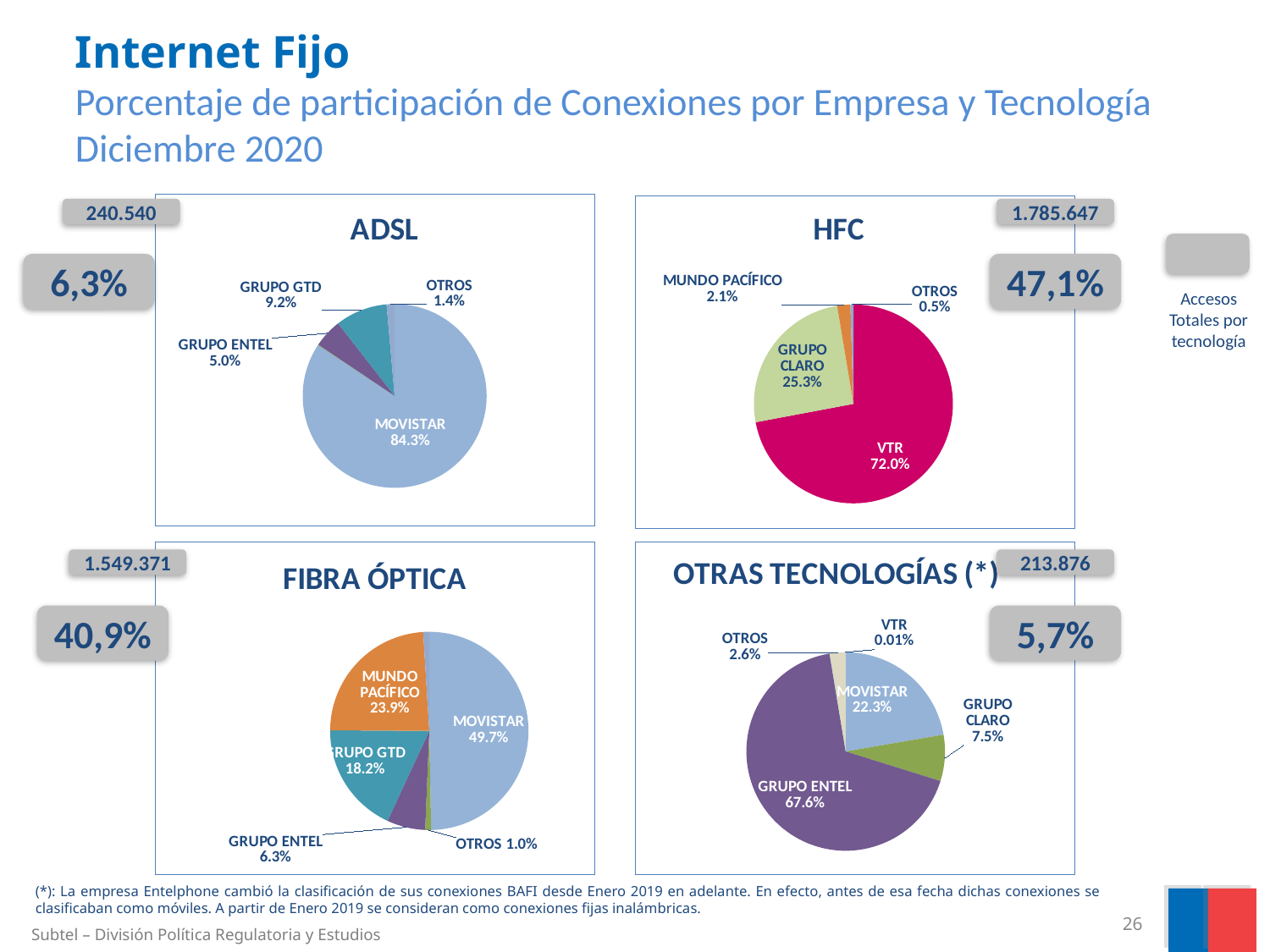
In the HFC chart, what is the value for GRUPO CLARO? 25.3% In the OTRAS TECNOLOGÍAS (*) chart, what is the difference between GRUPO ENTEL and MOVISTAR? 45.3% How many slices does the FIBRA ÓPTICA chart have? 6 How many pie charts are shown on the slide? 4 In the ADSL chart, what share does MOVISTAR hold? 84.3% What type of chart is the HFC chart? Pie chart In the HFC chart, which company has the largest share? VTR In the ADSL chart, which is larger, GRUPO GTD or GRUPO ENTEL? GRUPO GTD In the HFC chart, what is the combined share of MUNDO PACÍFICO and OTROS? 2.6% In the FIBRA ÓPTICA chart, what is the value for MUNDO PACÍFICO? 23.9% In the OTRAS TECNOLOGÍAS (*) chart, what is the value for VTR? 0.01%